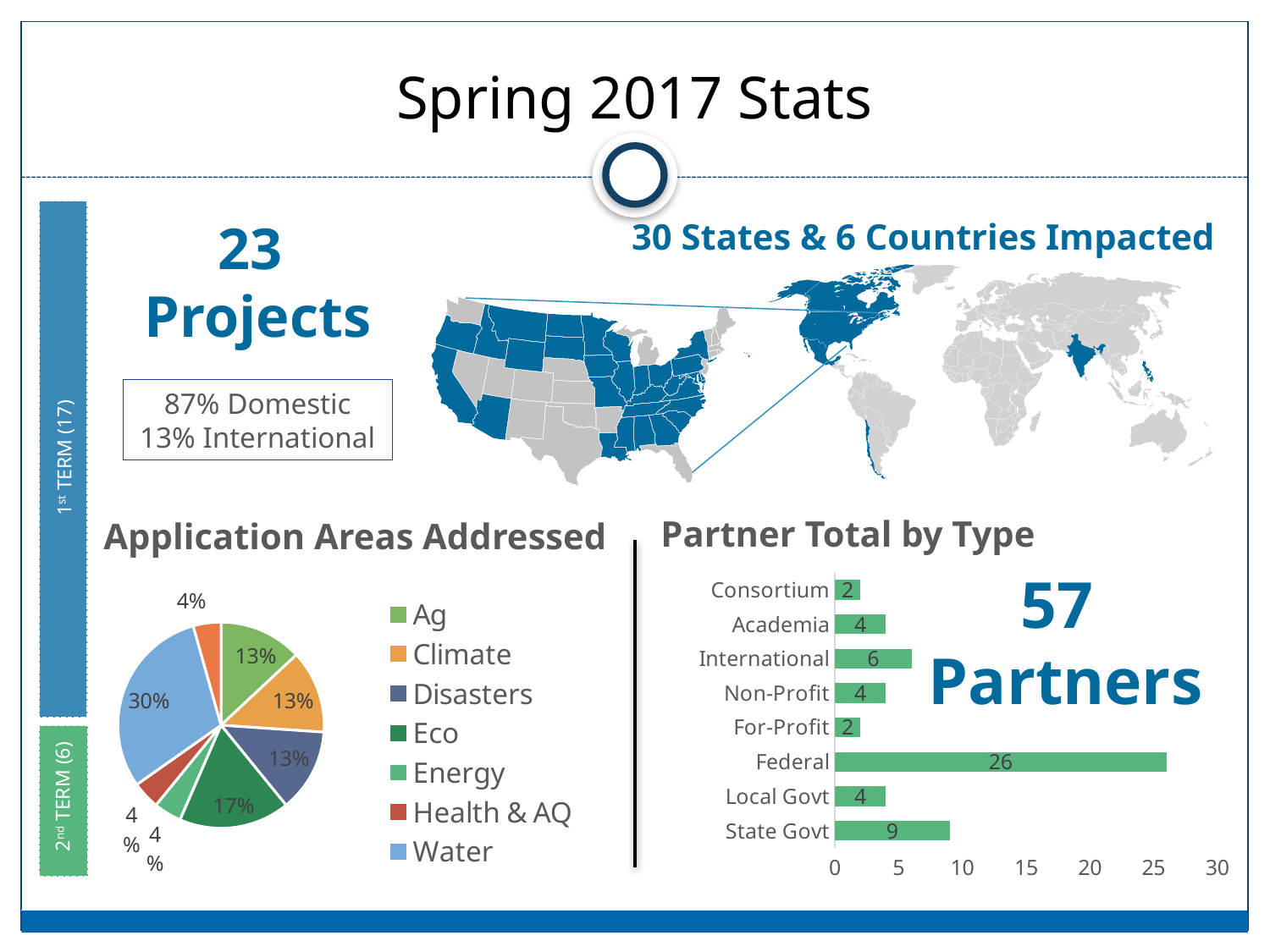
In the Partner Total by Type chart, is the value for Federal greater or less than 25? greater In the Application Areas Addressed pie chart, what share does Eco have? 17% How many entries does the legend of the Application Areas Addressed pie chart list? 7 In the Partner Total by Type chart, what is the difference between the Federal and State Govt values? 17 How many partner types are shown in the Partner Total by Type chart? 8 In the Application Areas Addressed pie chart, what share does Water have? 30% In the Partner Total by Type chart, what is the value for Federal? 26 In the Partner Total by Type chart, which is larger, International or Academia? International In the Partner Total by Type chart, what is the value for International? 6 In the Partner Total by Type chart, which partner type has the highest value? Federal In the Partner Total by Type chart, what is the value for State Govt? 9 What kind of chart is the Partner Total by Type chart? bar chart